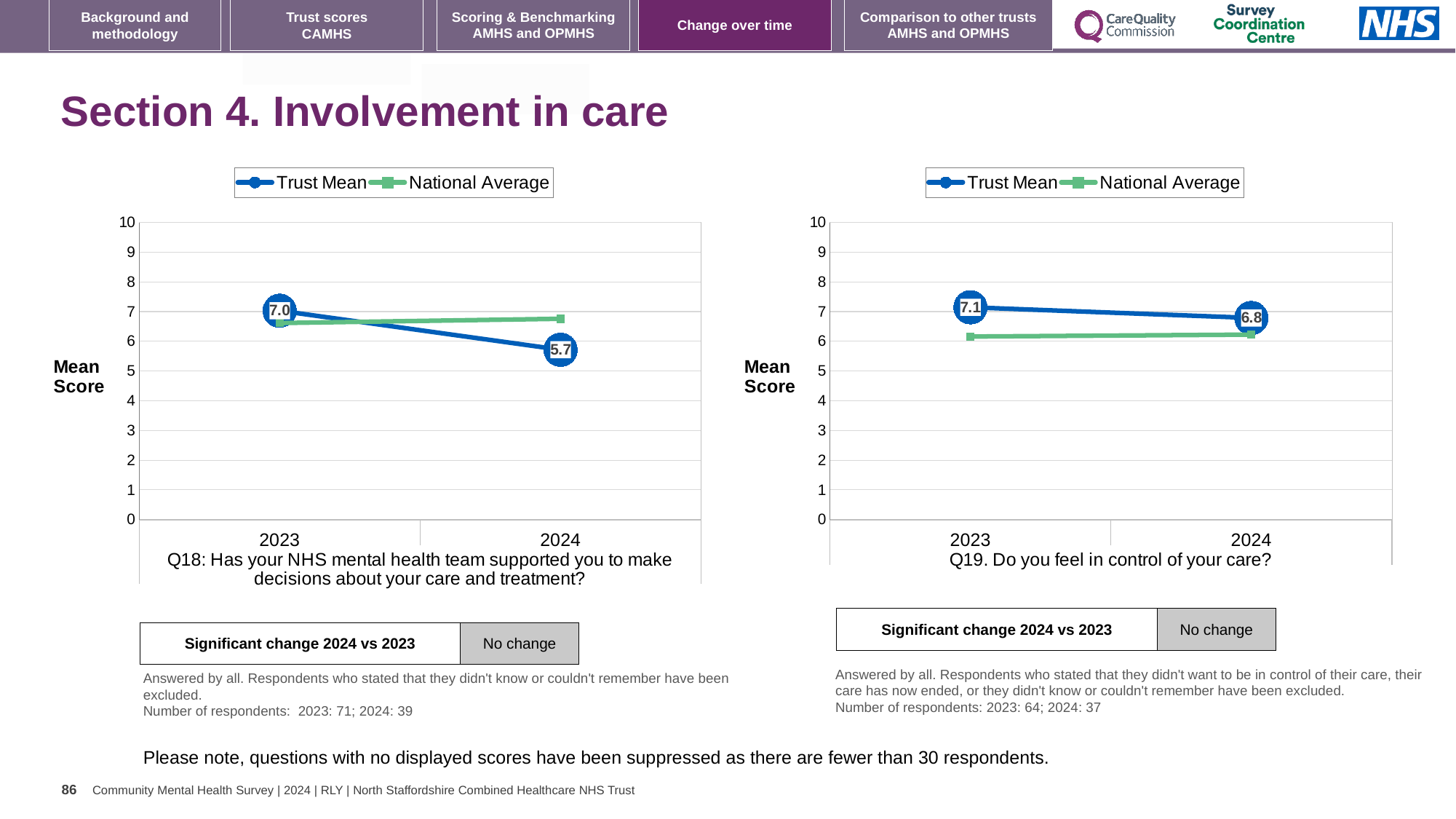
In the Q18 chart (left), does the Trust Mean rise or fall from 2023 to 2024? fall In the Q19 chart (right), what is the Trust Mean score for 2024? 6.8 In the Q19 chart (right), what is the Trust Mean score for 2023? 7.1 In the Q18 chart (left), what is the Trust Mean score for 2023? 7.0 In the Q18 chart (left), by how much did the Trust Mean fall from 2023 to 2024? 1.3 What type of chart is used for Q19 (right)? line chart In the Q19 chart (right), in 2023 which is higher, the Trust Mean or the National Average? Trust Mean In the Q19 chart (right), is the National Average for 2023 greater or less than 7? less How many series does the legend of the Q18 chart (left) list? 2 In the Q18 chart (left), in 2024 which is higher, the Trust Mean or the National Average? National Average In the Q18 chart (left), what is the Trust Mean score for 2024? 5.7 In the Q19 chart (right), what is the difference between the Trust Mean in 2023 and 2024? 0.3